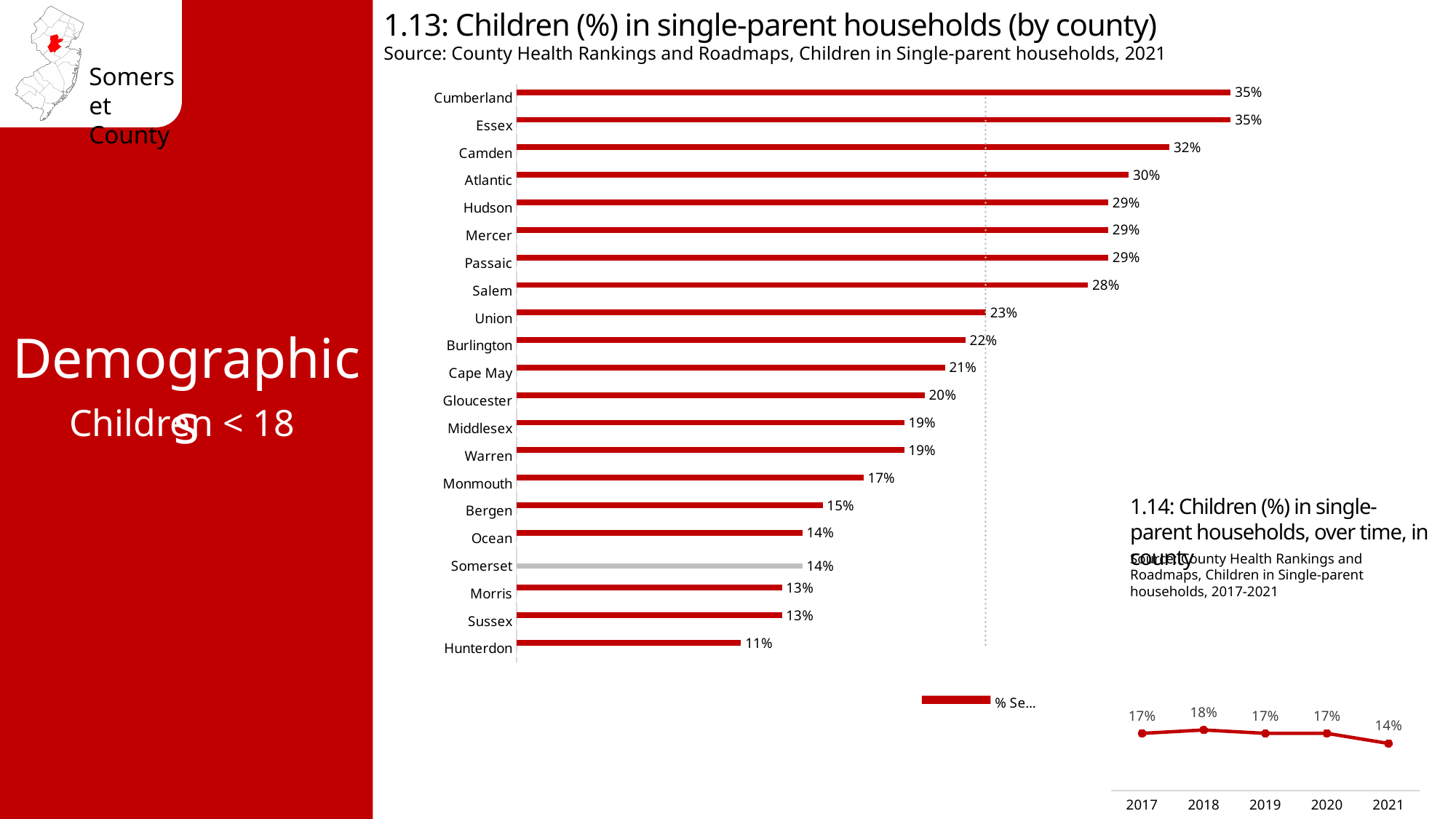
What kind of chart is chart 1.13 (by county)? Bar chart What kind of chart is chart 1.14 (over time, in county)? Line chart In chart 1.13 (Children (%) in single-parent households by county), what is the value for Somerset? 14% In chart 1.14 (over time, in county), which year has the lowest value? 2021 In chart 1.14 (over time, in county), what is the value for 2018? 18% In chart 1.13 (by county), which county has the lowest percentage of children in single-parent households? Hunterdon In chart 1.13 (by county), what is the difference between the values for Cumberland and Hunterdon? 24 percentage points In chart 1.13 (by county), which is larger, the value for Union or the value for Monmouth? Union In chart 1.13 (by county), what is the value for Hudson? 29% In chart 1.13 (by county), what is the value for Salem? 28% In chart 1.14 (over time, in county), how many years are plotted? 5 In chart 1.13 (by county), how many counties are shown? 21